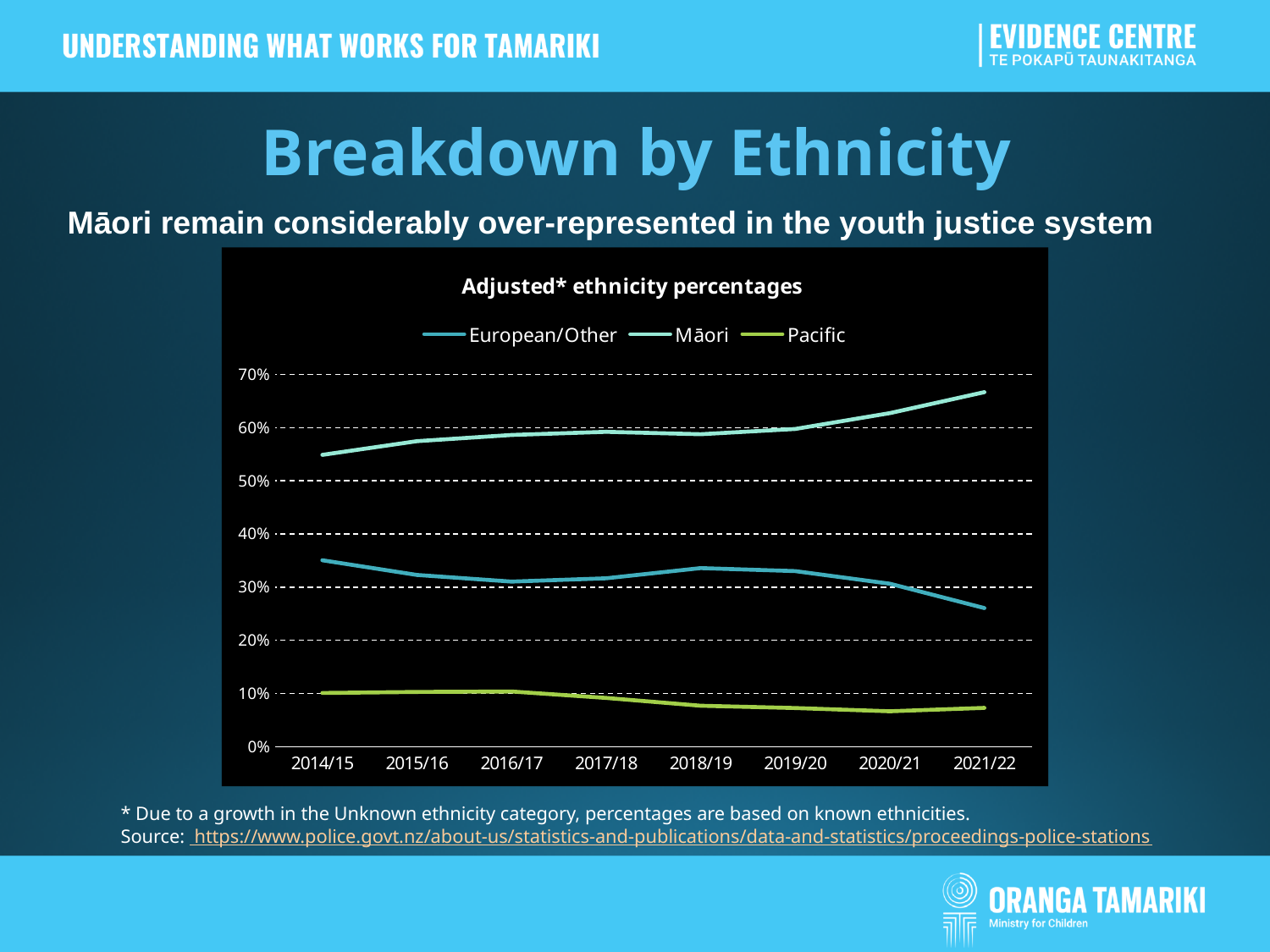
How many series does the legend list? 3 How many years are shown along the x axis? 8 What kind of chart is shown on the slide? line chart Which series has the lowest value in 2021/22? Pacific Does the Māori line rise or fall from 2014/15 to 2021/22? rise Is the value for Pacific in 2021/22 greater or less than 10%? less Is the value for European/Other in 2021/22 greater or less than 30%? less Is the value for Māori in 2014/15 greater or less than 50%? greater Which is larger in 2014/15, the value for Māori or the value for European/Other? Māori Which series has the highest value in 2021/22? Māori What is the title of the chart? Adjusted* ethnicity percentages